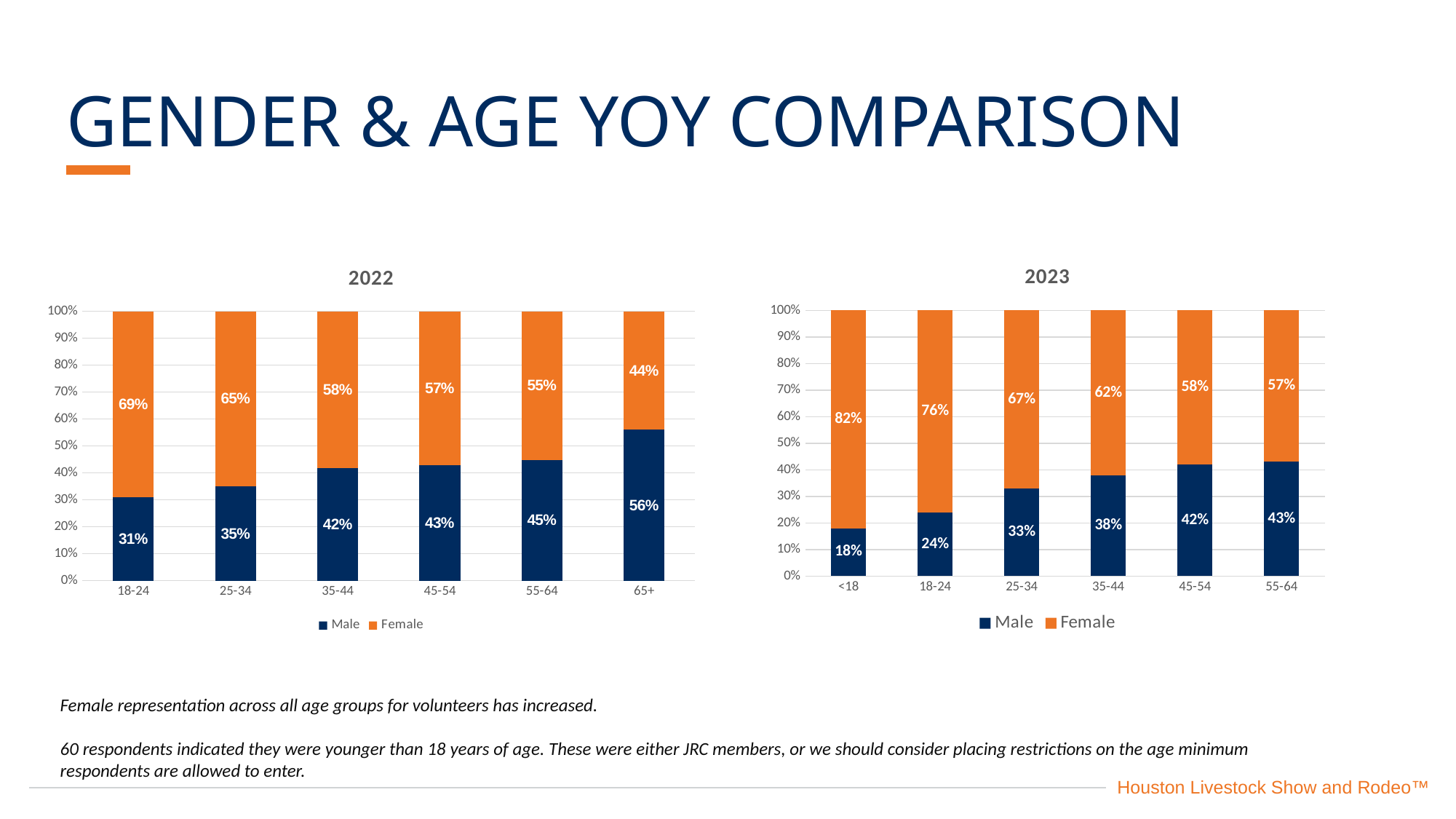
In the 2023 chart, do the Male values rise or fall as the age groups go from <18 to 55-64? Rise How many age groups are shown in the 2023 chart? 6 In the 2022 chart, which age group has the highest Male value? 65+ In the 2023 chart, which age group has the lowest Male value? <18 In the 2022 chart, what is the Female value for the 18-24 age group? 69% In the 2023 chart, what is the difference between the Female and Male values for the <18 age group? 64% Which colour represents Female in both charts? Orange In the 2023 chart, what is the Male value for the 35-44 age group? 38% What kind of chart is the 2023 chart? Stacked bar chart In the 2022 chart, which is larger for the 65+ age group, the Male value or the Female value? Male In the 2022 chart, what is the total of the Male and Female values for the 45-54 age group? 100% How many series does the legend of the 2022 chart list? 2